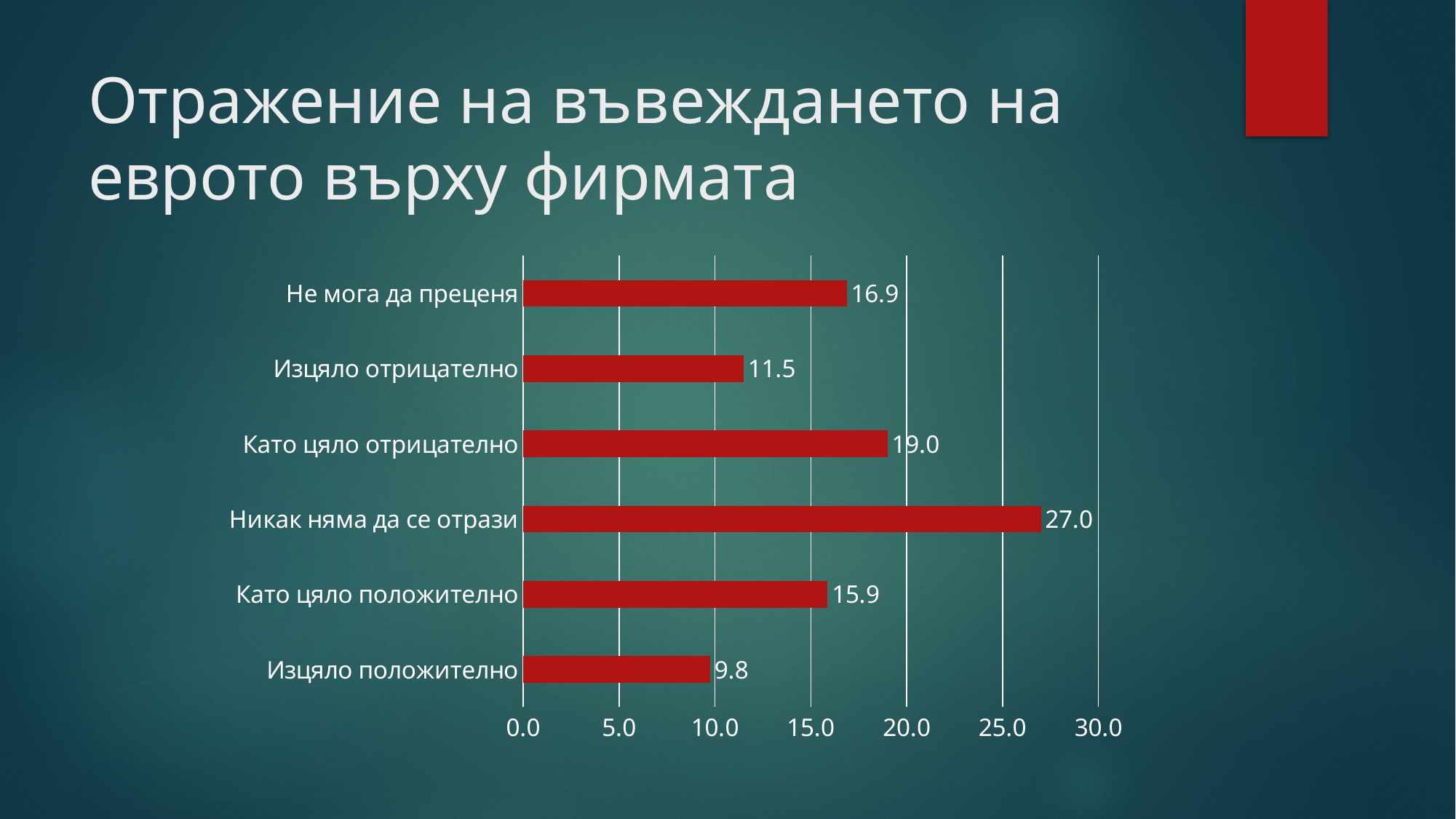
What is the title of the slide? Отражение на въвеждането на еврото върху фирмата Which category has the highest value? Никак няма да се отрази What is the value for "Изцяло положително"? 9.8 What is the value for "Никак няма да се отрази"? 27.0 What kind of chart is shown on the slide? Bar chart What is the difference between the values for "Изцяло отрицателно" and "Изцяло положително"? 1.7 What is the value for "Като цяло отрицателно"? 19.0 How many categories are shown in the chart? 6 What is the value for "Не мога да преценя"? 16.9 Which category has the lowest value? Изцяло положително Which is larger, the value for "Като цяло положително" or the value for "Изцяло отрицателно"? Като цяло положително What is the difference between the values for "Никак няма да се отрази" and "Като цяло отрицателно"? 8.0